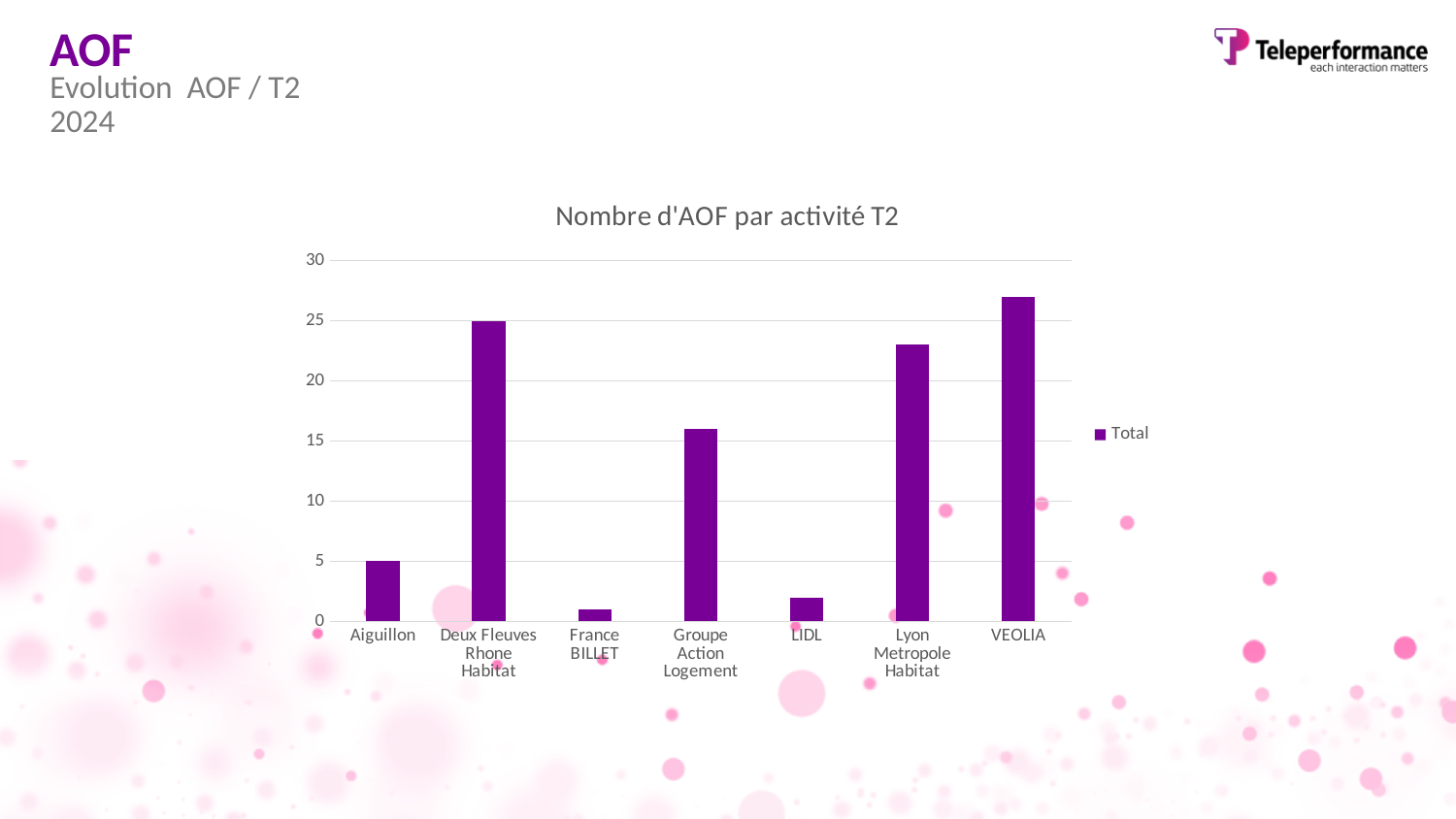
What is the title of the chart? Nombre d'AOF par activité T2 Is the value for VEOLIA greater or less than 25? greater What is the name of the series shown in the legend? Total Is the value for LIDL greater or less than 5? less Which is larger, the value for Groupe Action Logement or the value for Lyon Metropole Habitat? Lyon Metropole Habitat How many categories are shown on the x axis of the chart? 7 How many series does the legend list? 1 What type of chart is shown on the slide? bar chart What is the value for Deux Fleuves Rhone Habitat? 25 Is the value for Groupe Action Logement greater or less than 15? greater What is the value for Aiguillon? 5 Which category has the highest value? VEOLIA